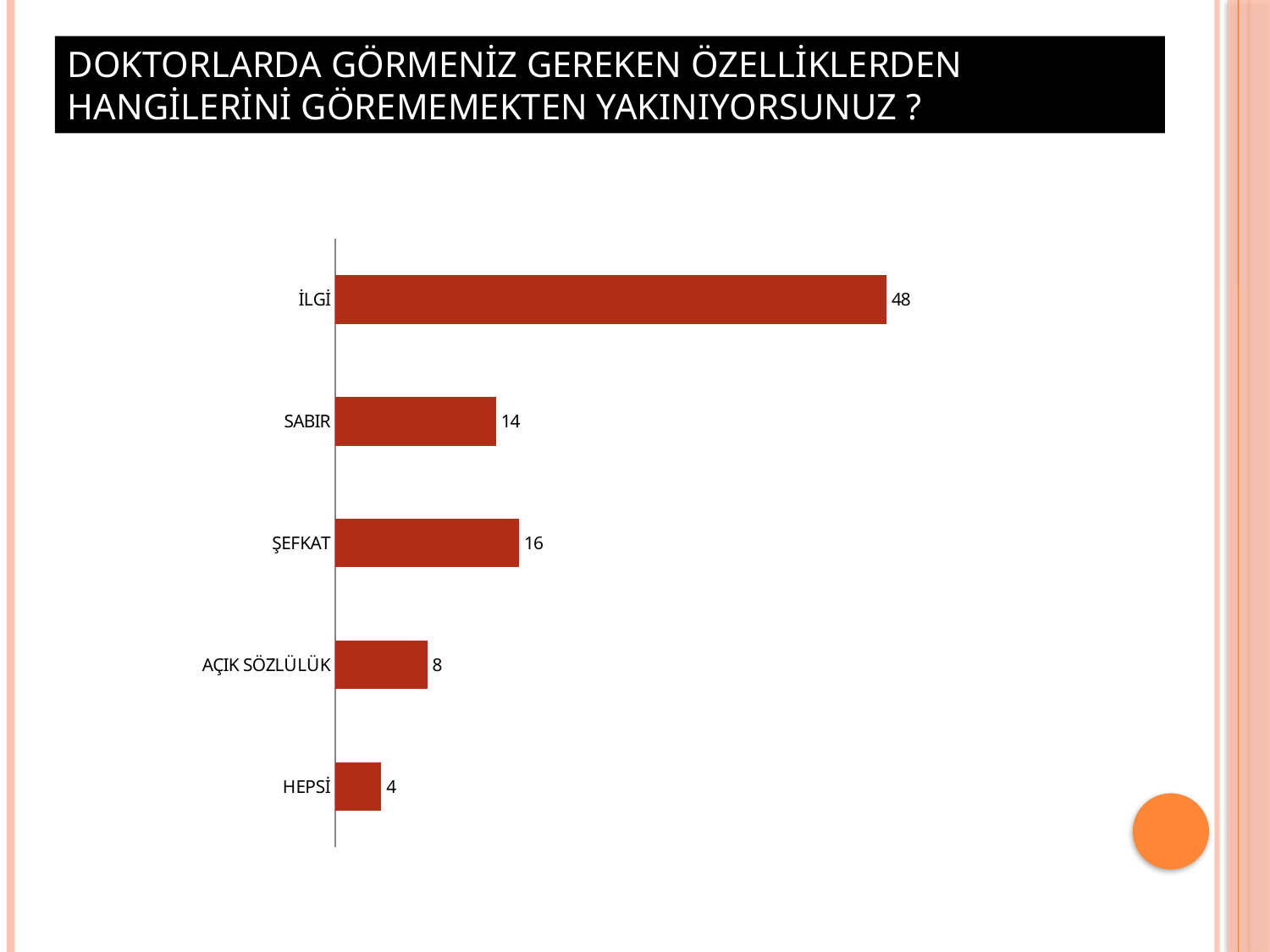
Which is larger, the value for AÇIK SÖZLÜLÜK or the value for HEPSİ? AÇIK SÖZLÜLÜK What is the difference between the values for ŞEFKAT and SABIR? 2 How many categories are shown in the chart? 5 What is the value for AÇIK SÖZLÜLÜK? 8 Which category has the lowest value? HEPSİ What is the value for SABIR? 14 What is the value for HEPSİ? 4 What kind of chart is shown on the slide? bar chart What is the value for İLGİ? 48 Which category has the highest value? İLGİ What is the value for ŞEFKAT? 16 What is the difference between the values for İLGİ and ŞEFKAT? 32